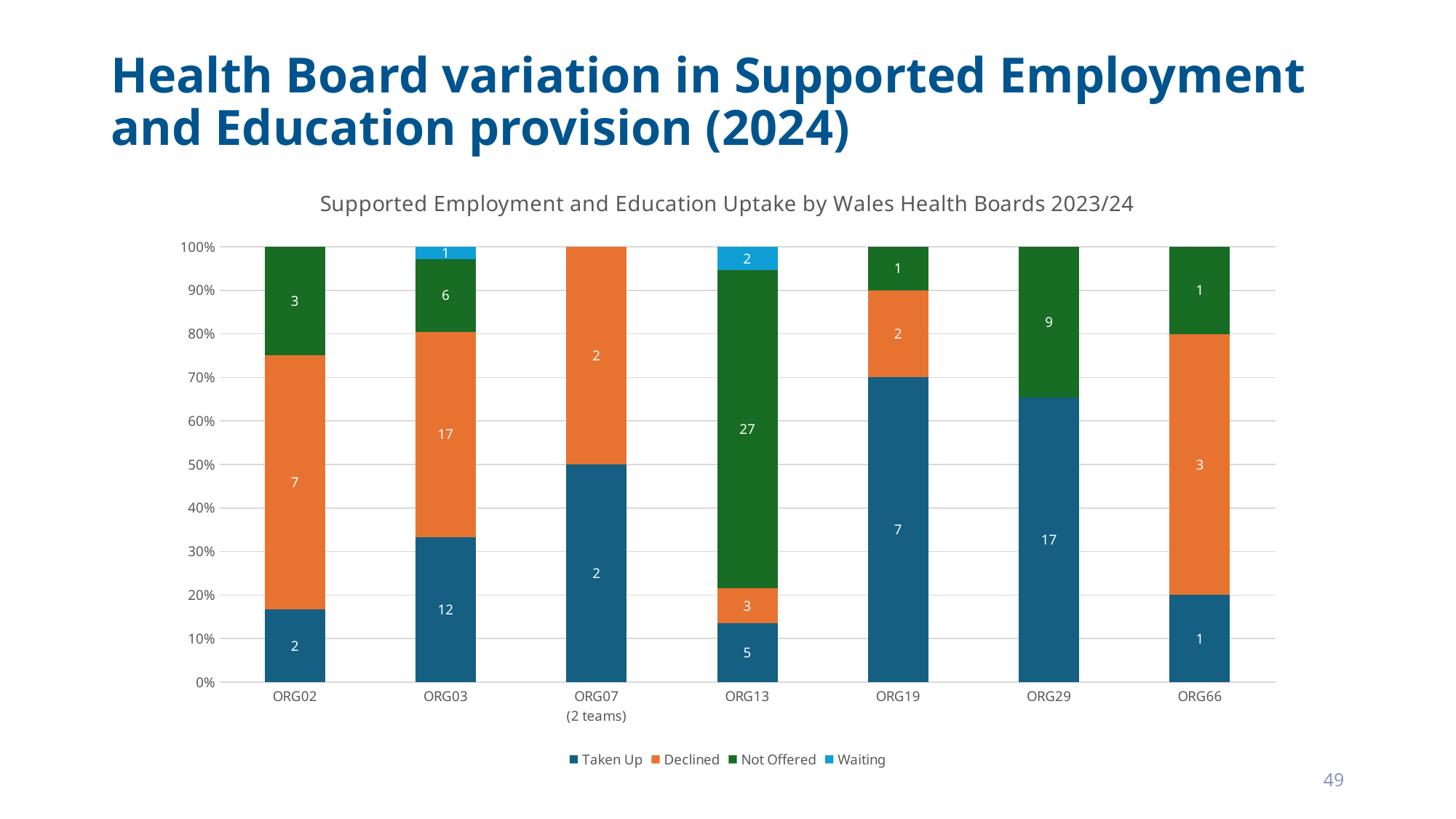
How many health boards are shown on the x axis? 7 What is the Taken Up value for ORG03? 12 Is the Taken Up share of the ORG19 bar greater or less than 60%? greater Which is larger, the Not Offered value for ORG29 or for ORG03? ORG29 What is the total of the labelled values in the ORG02 bar? 12 How many series does the legend list? 4 What is the Declined value for ORG66? 3 What kind of chart is shown on the slide? Stacked bar chart What is the difference between the Declined values for ORG03 and ORG02? 10 What is the Not Offered value for ORG13? 27